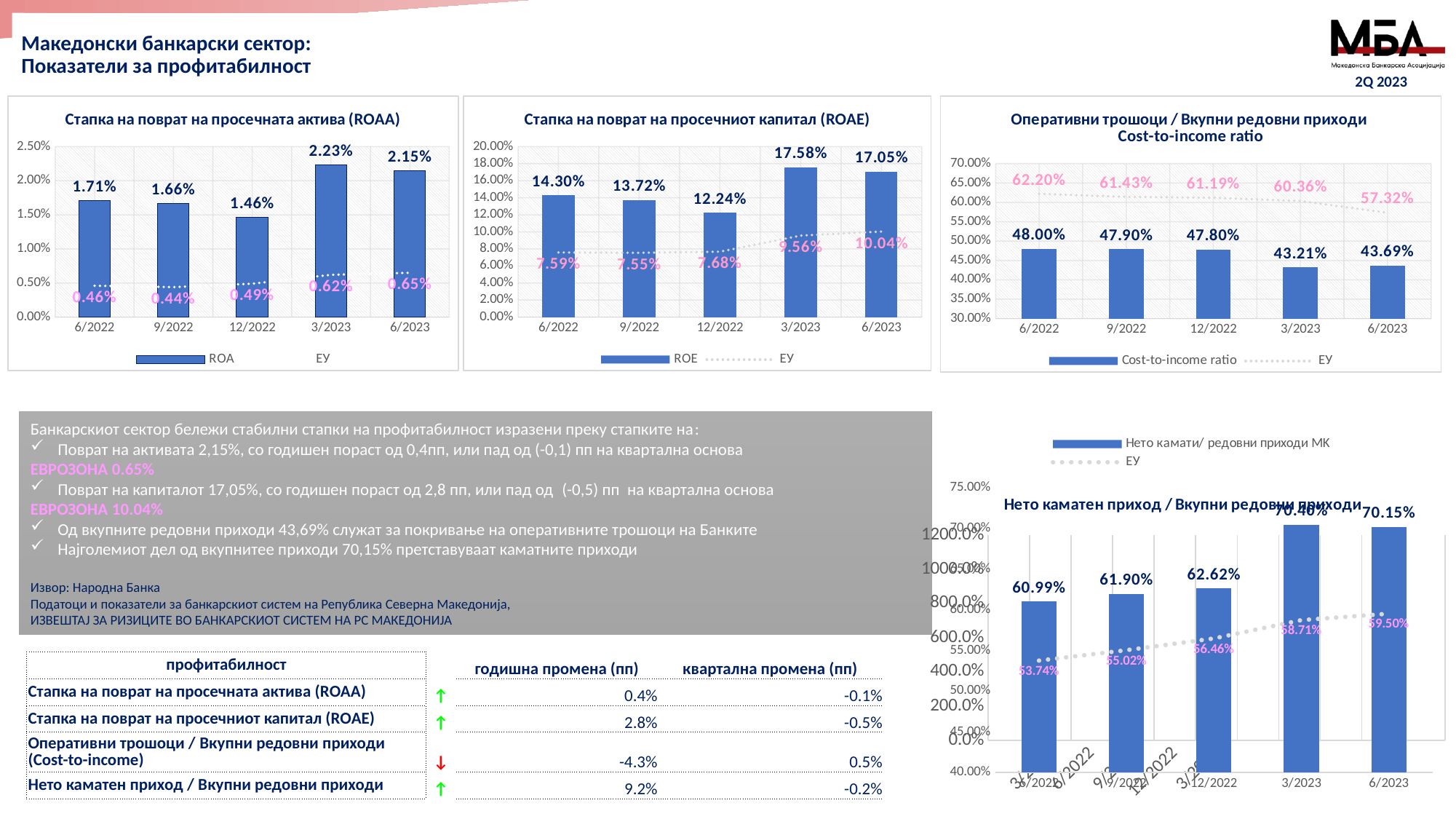
In the ROAA chart, which period has the highest ROA value? 3/2023 How many periods are shown on the x axis of the ROAA chart? 5 In the Cost-to-income ratio chart, what is the EU value for 6/2023? 57.32% In the ROAE chart, what is the ROE value for 12/2022? 12.24% In the ROAE chart, what is the difference between the ROE value for 3/2023 and the ROE value for 6/2023? 0.53% In the ROAE chart, which period has the lowest ROE value? 12/2022 How many series does the legend of the ROAE chart list? 2 In the Cost-to-income ratio chart, what is the Cost-to-income ratio for 3/2023? 43.21% In the Cost-to-income ratio chart, is the Cost-to-income ratio for 6/2022 larger or smaller than the EU value for 6/2022? smaller In the bottom-right chart (Нето каматен приход / Вкупни редовни приходи), what is the value for 6/2023? 70.15% In the ROAA chart, what is the EU value for 12/2022? 0.49% In the ROAA chart, what is the ROA value for 6/2023? 2.15%